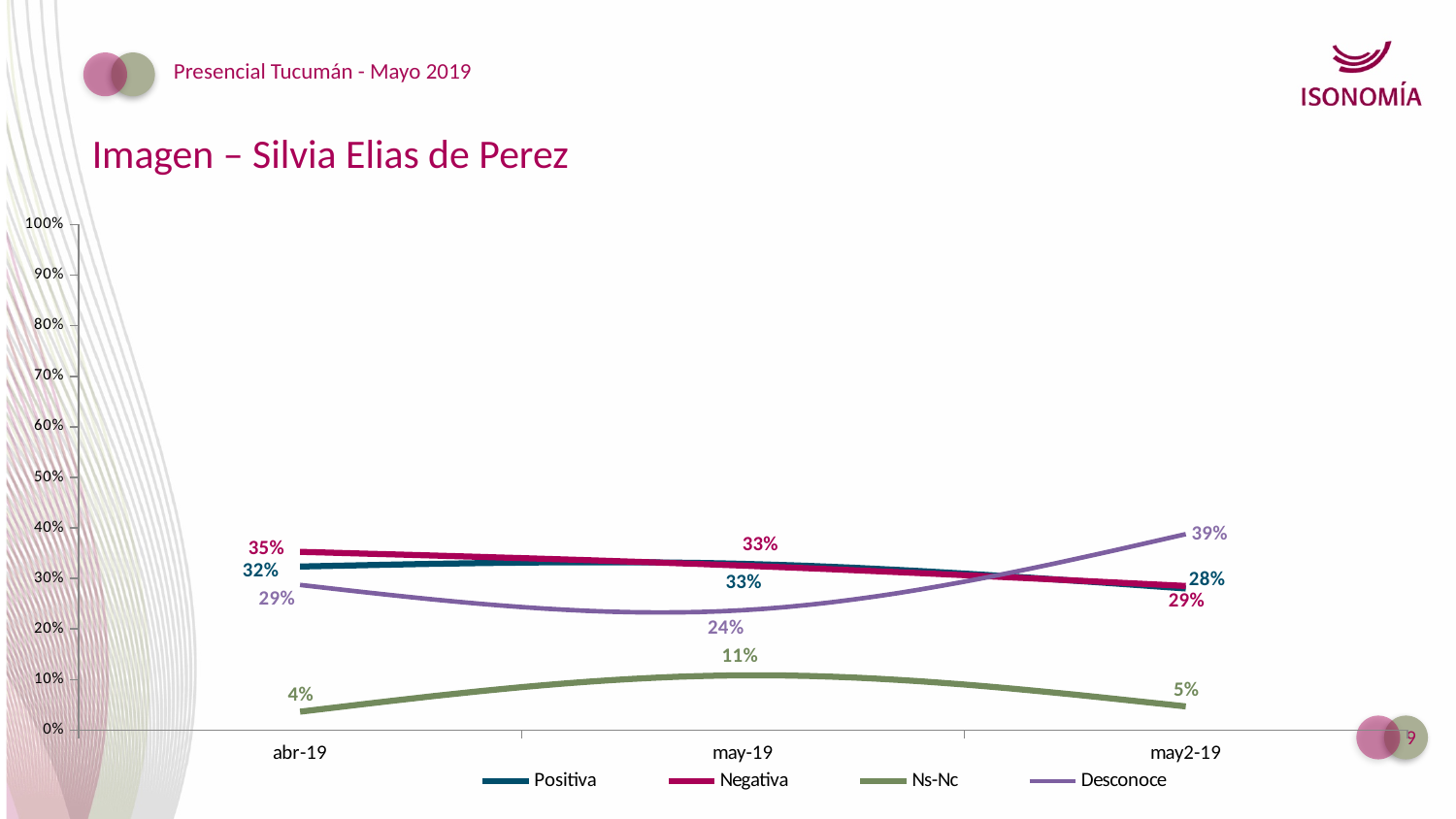
What kind of chart is shown on the slide? line chart What is the value for Negativa at abr-19? 35% Which series has the highest value at may2-19? Desconoce What is the value for Ns-Nc at may-19? 11% What is the difference between the Desconoce values at may2-19 and may-19? 15% What is the title of the chart? Imagen – Silvia Elias de Perez What is the value for Desconoce at may2-19? 39% How many points are on the x axis? 3 How many series does the legend list? 4 Which series has the lowest value at abr-19? Ns-Nc Does the Ns-Nc series rise or fall from abr-19 to may-19? rise What is the value for Positiva at may2-19? 28%